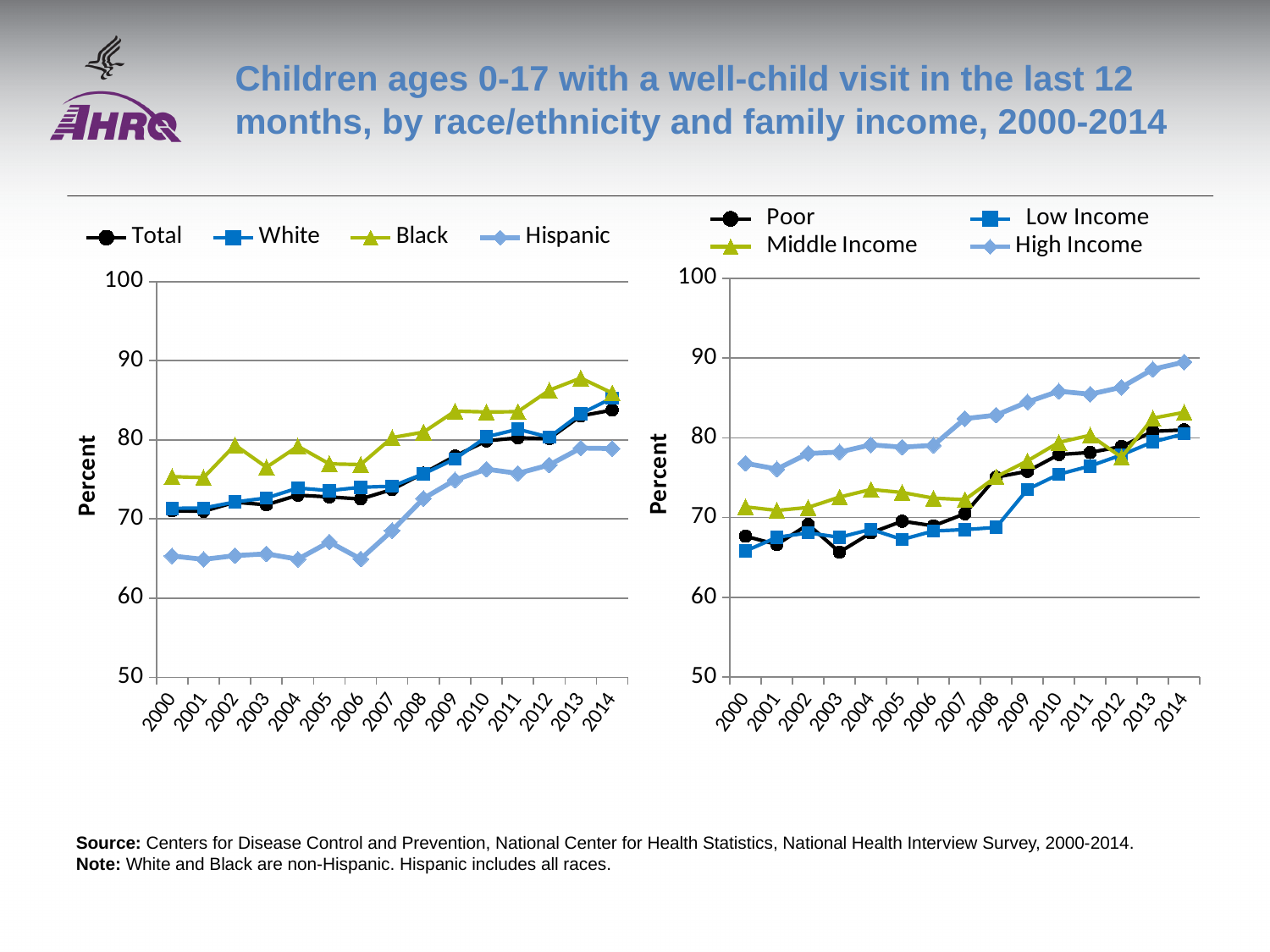
In the right chart (by family income), is the value for High Income in 2014 greater or less than 80? greater In the left chart (by race/ethnicity), which series has the lowest value in 2000? Hispanic In the right chart (by family income), which series has the highest value in 2014? High Income In the right chart (by family income), which is larger in 2008: High Income or Middle Income? High Income In the right chart (by family income), is the value for Poor in 2003 greater or less than 70? less How many series does the legend of the left chart (by race/ethnicity) list? 4 In the left chart (by race/ethnicity), is the value for Black in 2013 greater or less than 80? greater How many years are plotted along the x axis of the right chart (by family income)? 15 In the left chart (by race/ethnicity), does the Hispanic series rise or fall overall from 2000 to 2014? Rise How many series does the legend of the right chart (by family income) list? 4 What kind of chart is the left chart, showing rates by race/ethnicity? Line chart